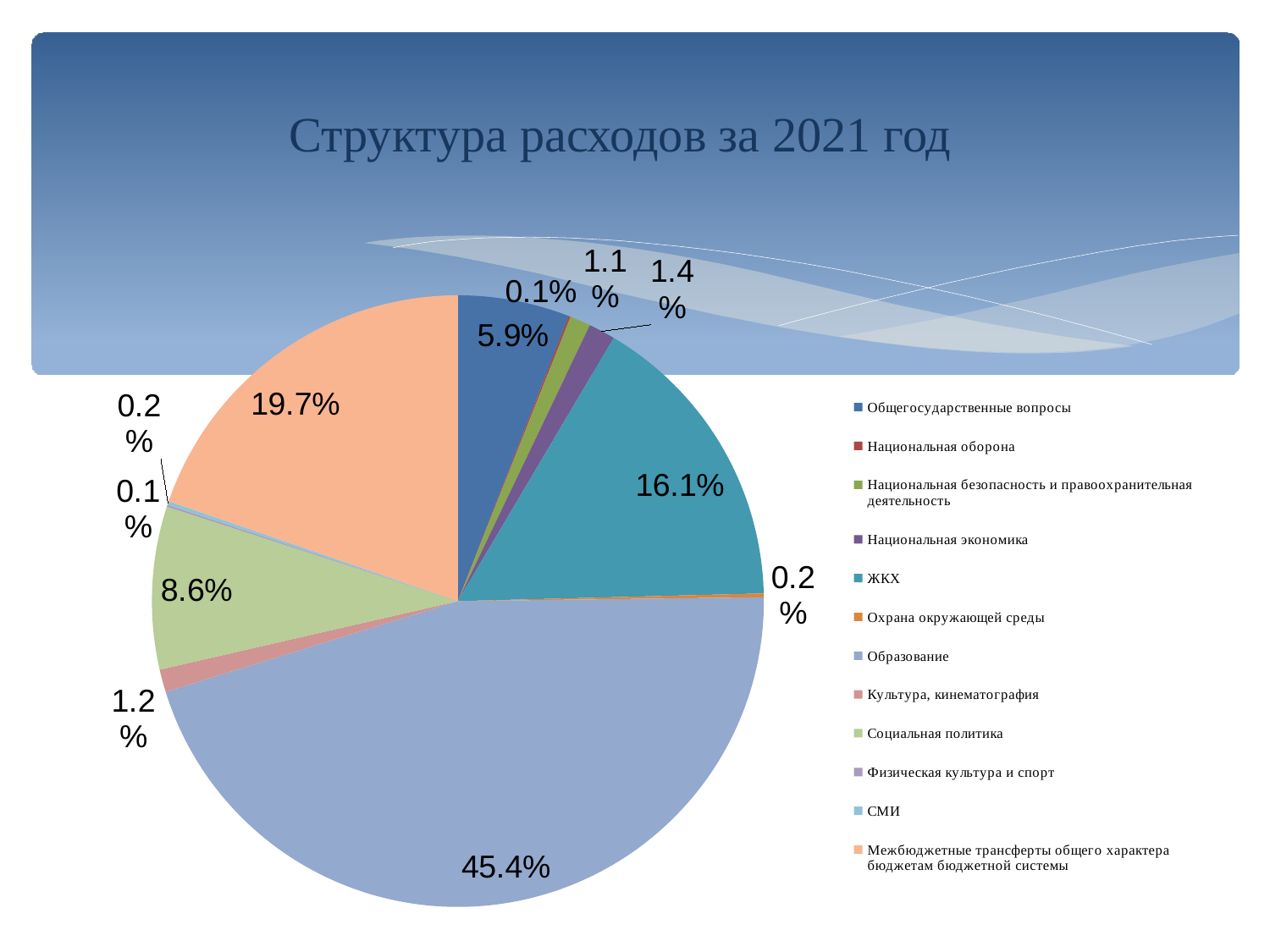
Which category has the largest share of expenditures? Образование Which is larger: the share for ЖКХ or the share for Социальная политика? ЖКХ What type of chart is shown on the slide? pie chart What share of expenditures is Межбюджетные трансферты общего характера бюджетам бюджетной системы? 19.7% What is the difference between the share for Образование and the share for Межбюджетные трансферты общего характера бюджетам бюджетной системы? 25.7% How many categories does the legend list? 12 What share of expenditures is Образование? 45.4% What share of expenditures is Национальная экономика? 1.4% What is the title of the chart? Структура расходов за 2021 год What share of expenditures is Социальная политика? 8.6% What share of expenditures is ЖКХ? 16.1% What share of expenditures is Общегосударственные вопросы? 5.9%